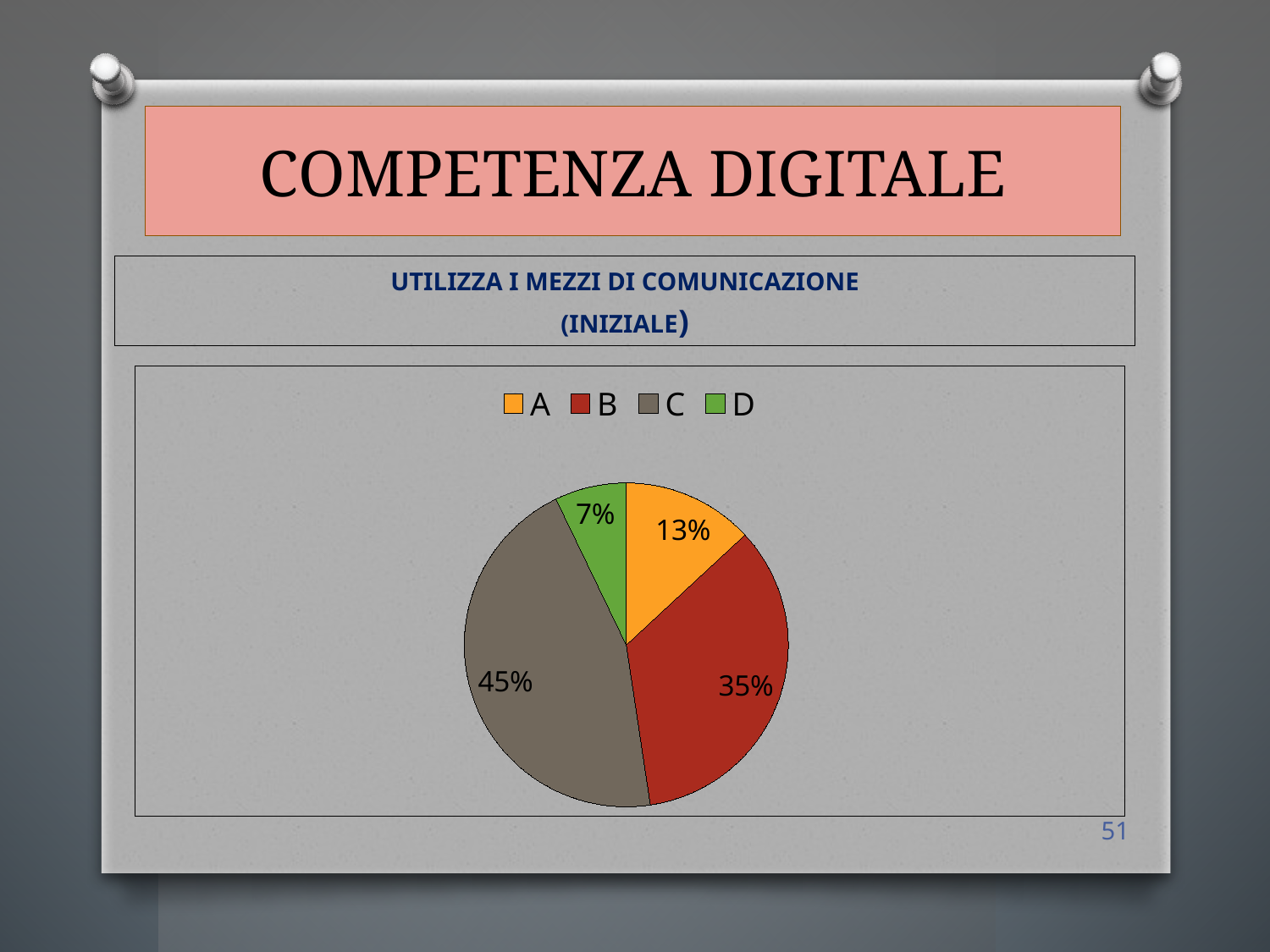
Which category has the smallest share of the pie? D How many slices does the pie chart have? 4 What percentage does slice D represent? 7% How many entries does the legend list? 4 What percentage does slice A represent? 13% What colour is the slice for category C? grey What percentage does slice B represent? 35% What percentage does slice C represent? 45% What kind of chart is shown on the slide? pie chart What is the difference in percentage points between slice C and slice B? 10 Which category has the largest share of the pie? C Which is larger, slice A or slice D? A